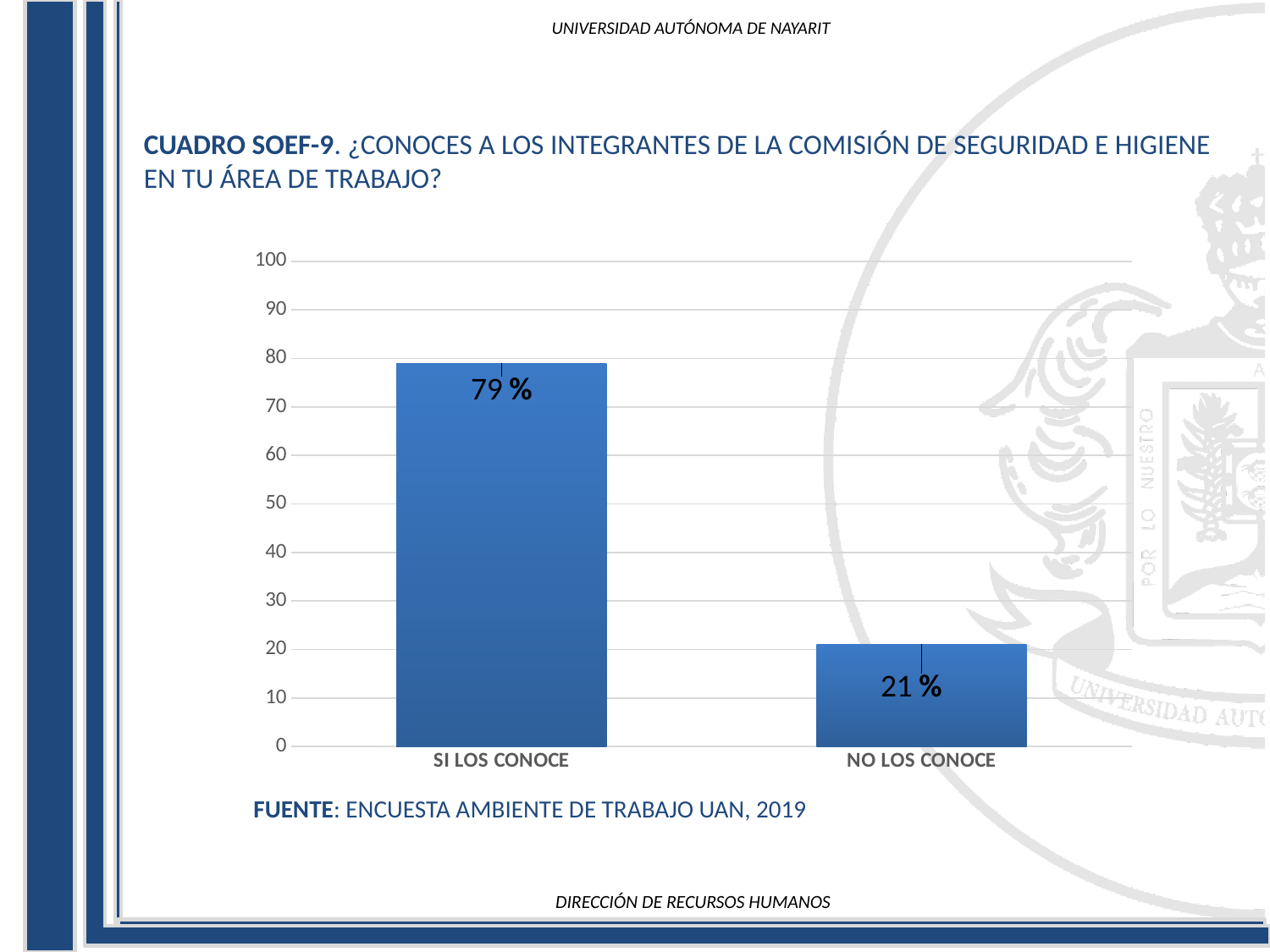
What source is cited below the chart? ENCUESTA AMBIENTE DE TRABAJO UAN, 2019 Is the value for SI LOS CONOCE greater or less than 70? greater Is the value for NO LOS CONOCE greater or less than 30? less Which category has the lowest value? NO LOS CONOCE What is the value for NO LOS CONOCE? 21 % What is the maximum value shown on the vertical axis? 100 How many categories are shown on the chart? 2 Which is larger, the value for SI LOS CONOCE or NO LOS CONOCE? SI LOS CONOCE What kind of chart is shown on the slide? bar chart What is the value for SI LOS CONOCE? 79 % Which category has the highest value? SI LOS CONOCE What is the difference between the values for SI LOS CONOCE and NO LOS CONOCE? 58 %